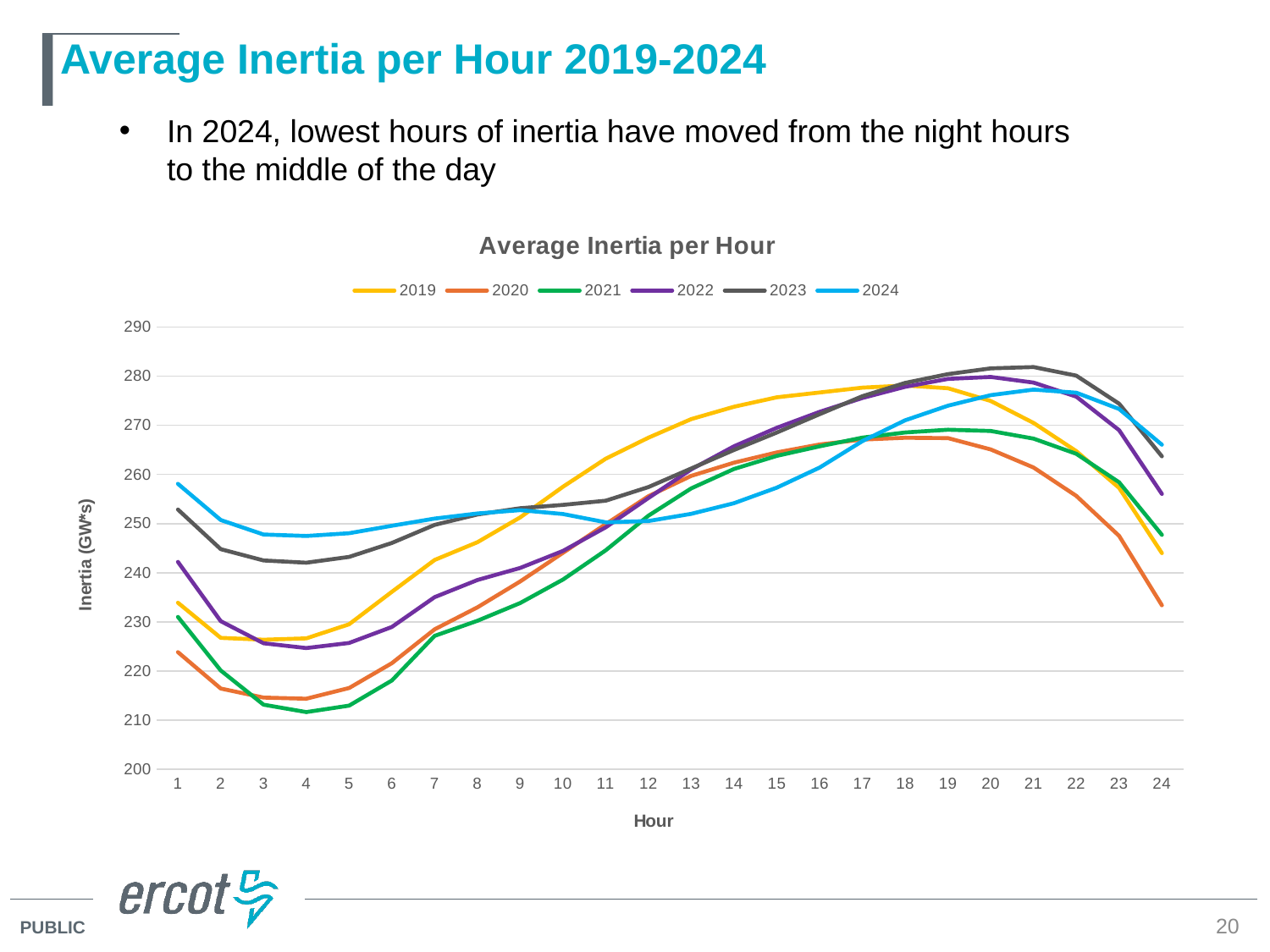
Does the 2021 line rise or fall from hour 4 to hour 19? Rise What is the label of the vertical axis of the chart? Inertia (GW*s) How many series does the chart legend list? 6 Is the value for 2021 at hour 4 greater or less than 220? less Which series has the lowest value at hour 24? 2020 At hour 4, which series has the larger value, 2024 or 2021? 2024 Is the value for 2024 at hour 1 greater or less than 250? greater What kind of chart is shown on the slide? Line chart How many hours are plotted along the x axis of the chart? 24 Is the value for 2020 at hour 24 greater or less than 240? less What is the title of the chart? Average Inertia per Hour